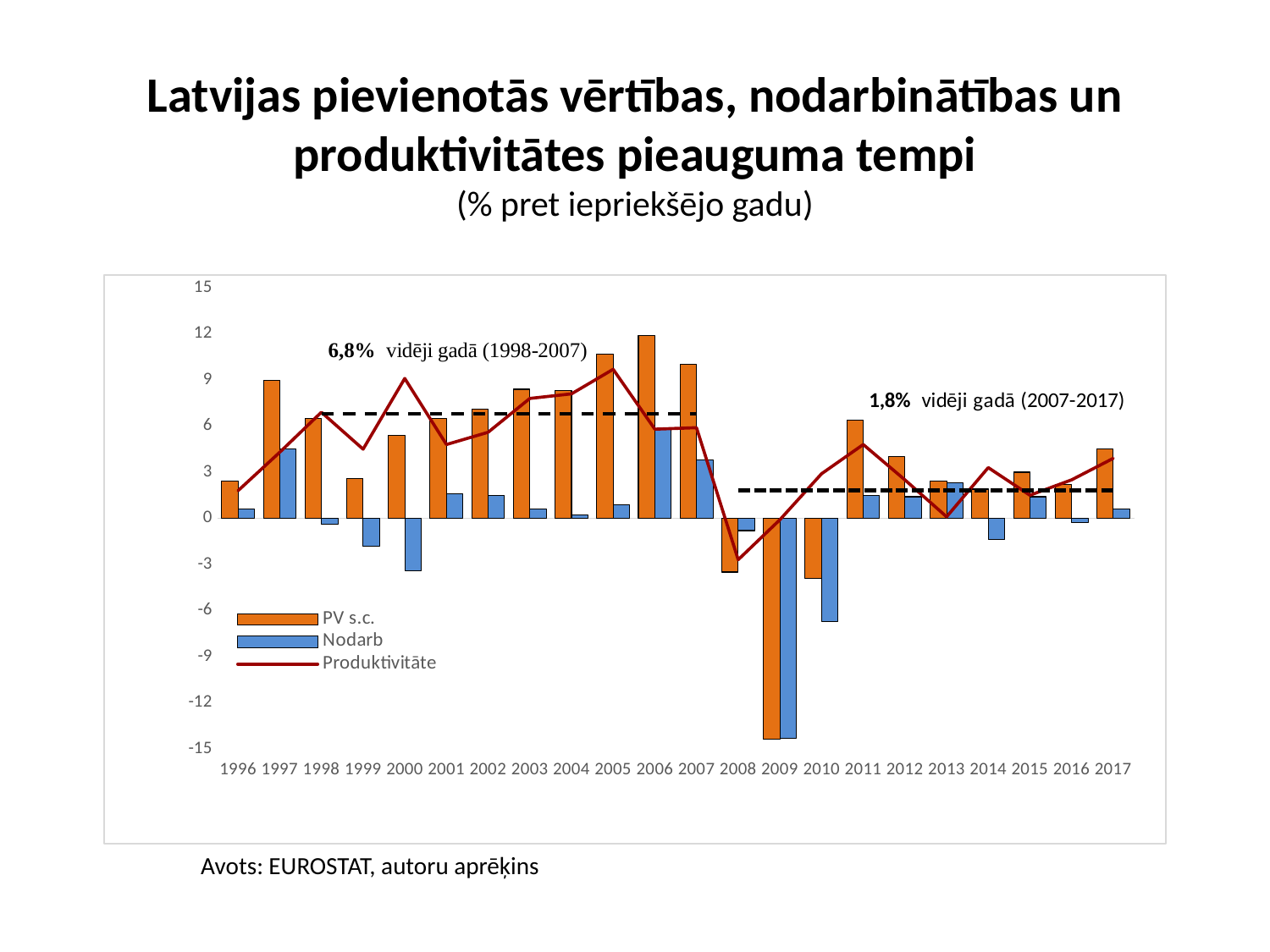
In which year is the PV s.c. bar the highest? 2006 In which year is the PV s.c. bar the lowest? 2009 How many years are shown on the x axis of the chart? 22 In which year is the Nodarb bar the lowest? 2009 Which series is drawn as a line rather than bars? Produktivitāte Which is larger, the PV s.c. value for 2006 or for 2007? 2006 Is the Nodarb value for 2010 greater or less than -3? less Is the PV s.c. value for 2006 greater or less than 9? greater How many series does the chart's legend list? 3 What kind of chart is shown on the slide? A combined bar and line chart What average annual growth is annotated for the period 1998-2007? 6,8% Is the PV s.c. value for 2009 greater or less than -12? less